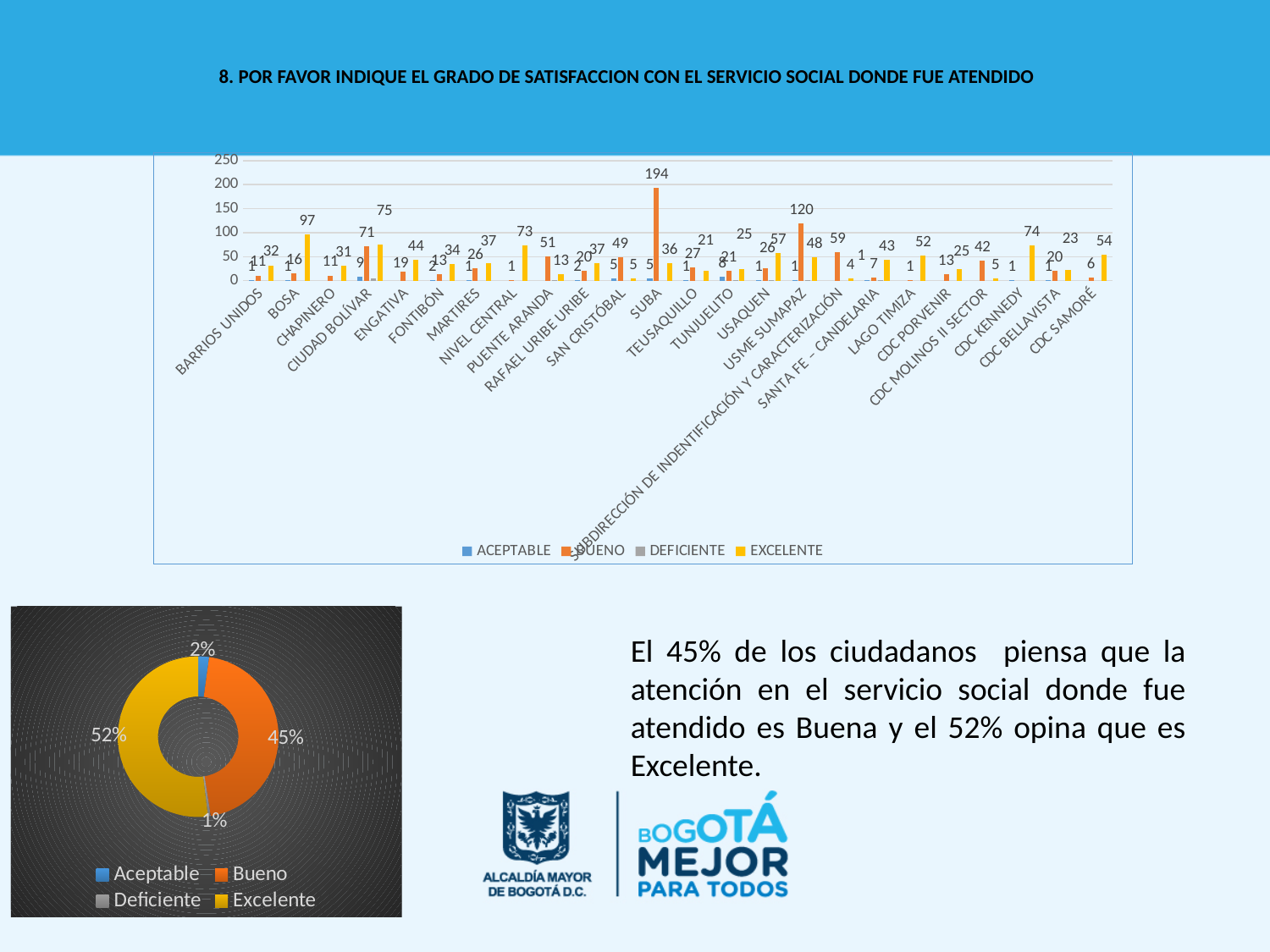
In the doughnut chart at the bottom left, which category has the smallest share? Deficiente In the bar chart at the top of the slide, is the tallest bar greater or less than 150? greater In the bar chart at the top of the slide, what is the value of the tallest bar? 194 In the doughnut chart at the bottom left, which category has the largest share? Excelente What kind of chart is the chart at the bottom left of the slide? Doughnut chart In the doughnut chart at the bottom left, how many percentage points larger is Excelente than Bueno? 7 percentage points In the doughnut chart at the bottom left, what share does Excelente have? 52% What kind of chart is the large chart at the top of the slide? Bar chart In the doughnut chart at the bottom left, what share does Aceptable have? 2% How many categories does the legend of the doughnut chart at the bottom left list? 4 In the doughnut chart at the bottom left, what share does Bueno have? 45% How many series does the legend of the bar chart at the top of the slide list? 4